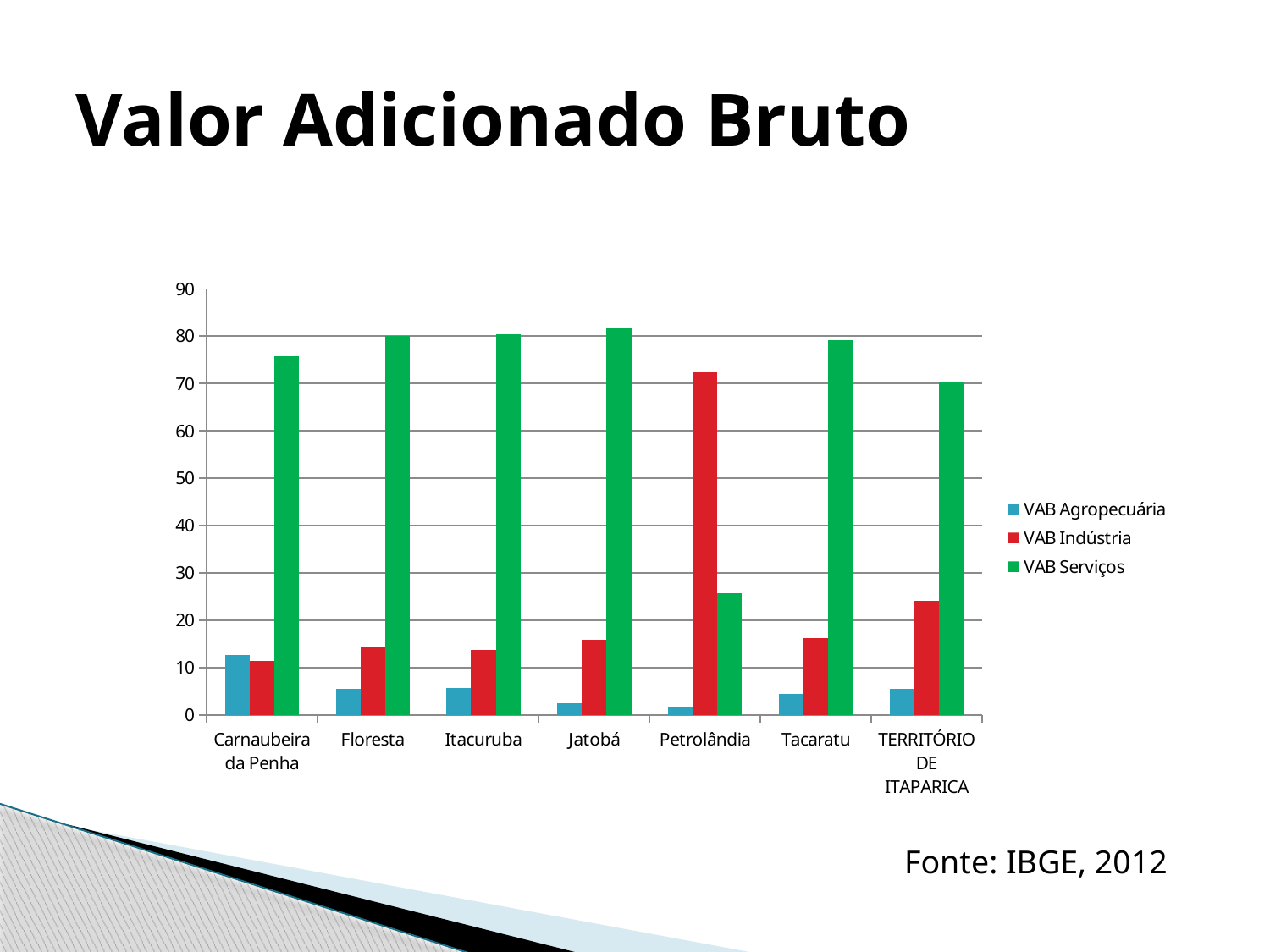
What colour represents VAB Serviços in the chart? Green How many categories are shown on the x axis of the chart? 7 What kind of chart is shown on the slide? Bar chart Is the VAB Serviços value for Carnaubeira da Penha greater or less than 70? greater Which category has the highest VAB Agropecuária value? Carnaubeira da Penha Which category has the lowest VAB Serviços value? Petrolândia Is the VAB Indústria value for Petrolândia greater or less than 70? greater How many series does the legend list? 3 Which category has the highest VAB Indústria value? Petrolândia Is the VAB Indústria value for TERRITÓRIO DE ITAPARICA greater or less than 20? greater Which is larger: the VAB Agropecuária value for Carnaubeira da Penha or for Floresta? Carnaubeira da Penha For Petrolândia, which is larger: VAB Indústria or VAB Serviços? VAB Indústria